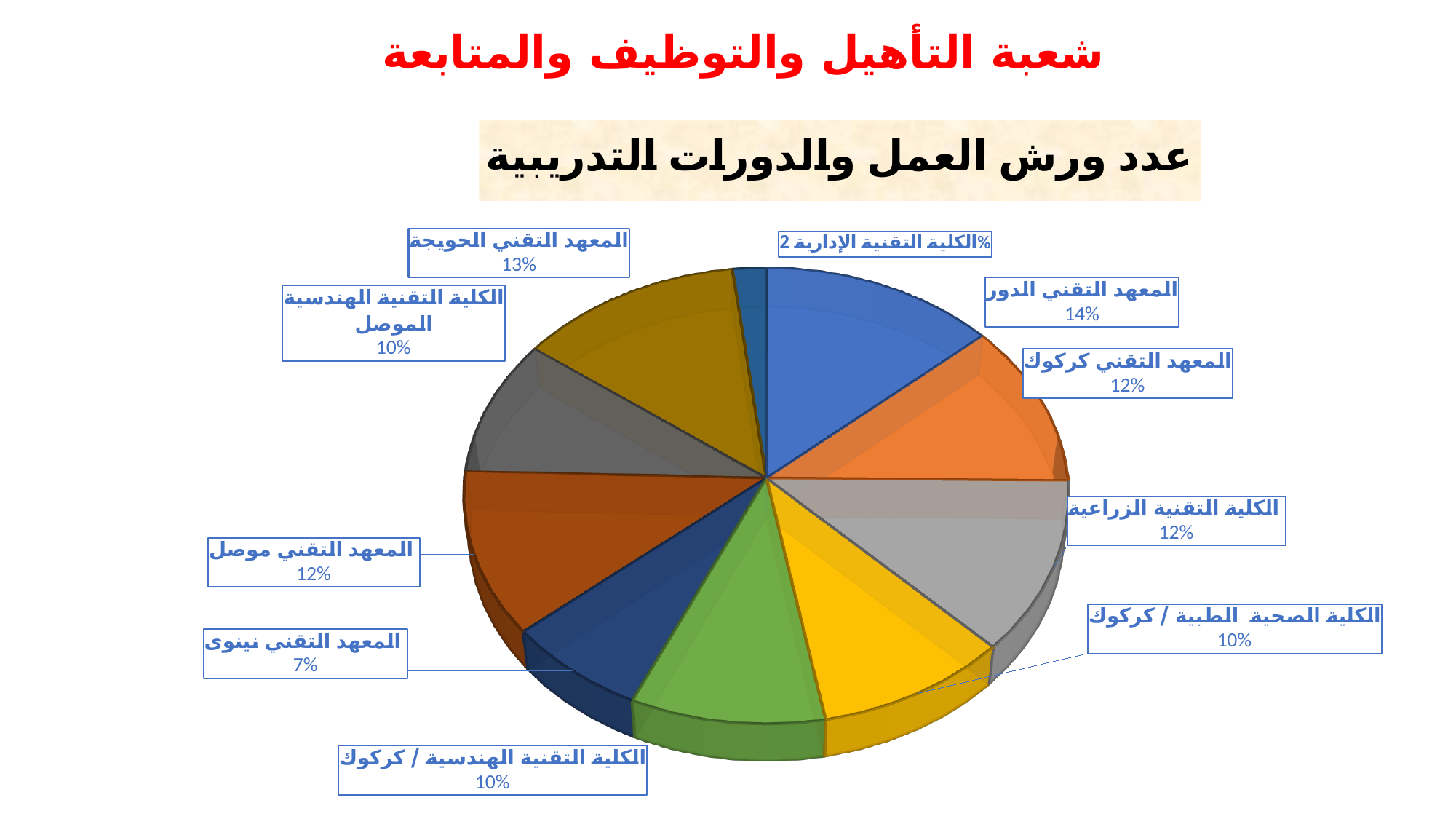
Which category has the smallest share of the pie? الكلية التقنية الإدارية What is the title of the chart? عدد ورش العمل والدورات التدريبية How many slices (categories) does the pie chart have? 10 What share of the pie does الكلية التقنية الإدارية have? 2% Which category has the largest share of the pie? المعهد التقني الدور What share of the pie does المعهد التقني الحويجة have? 13% Which has a larger share, المعهد التقني الحويجة or الكلية الصحية الطبية / كركوك? المعهد التقني الحويجة What share of the pie does المعهد التقني الدور have? 14% What is the difference in percentage points between المعهد التقني الدور and المعهد التقني نينوى? 7 What kind of chart is shown on the slide? Pie chart